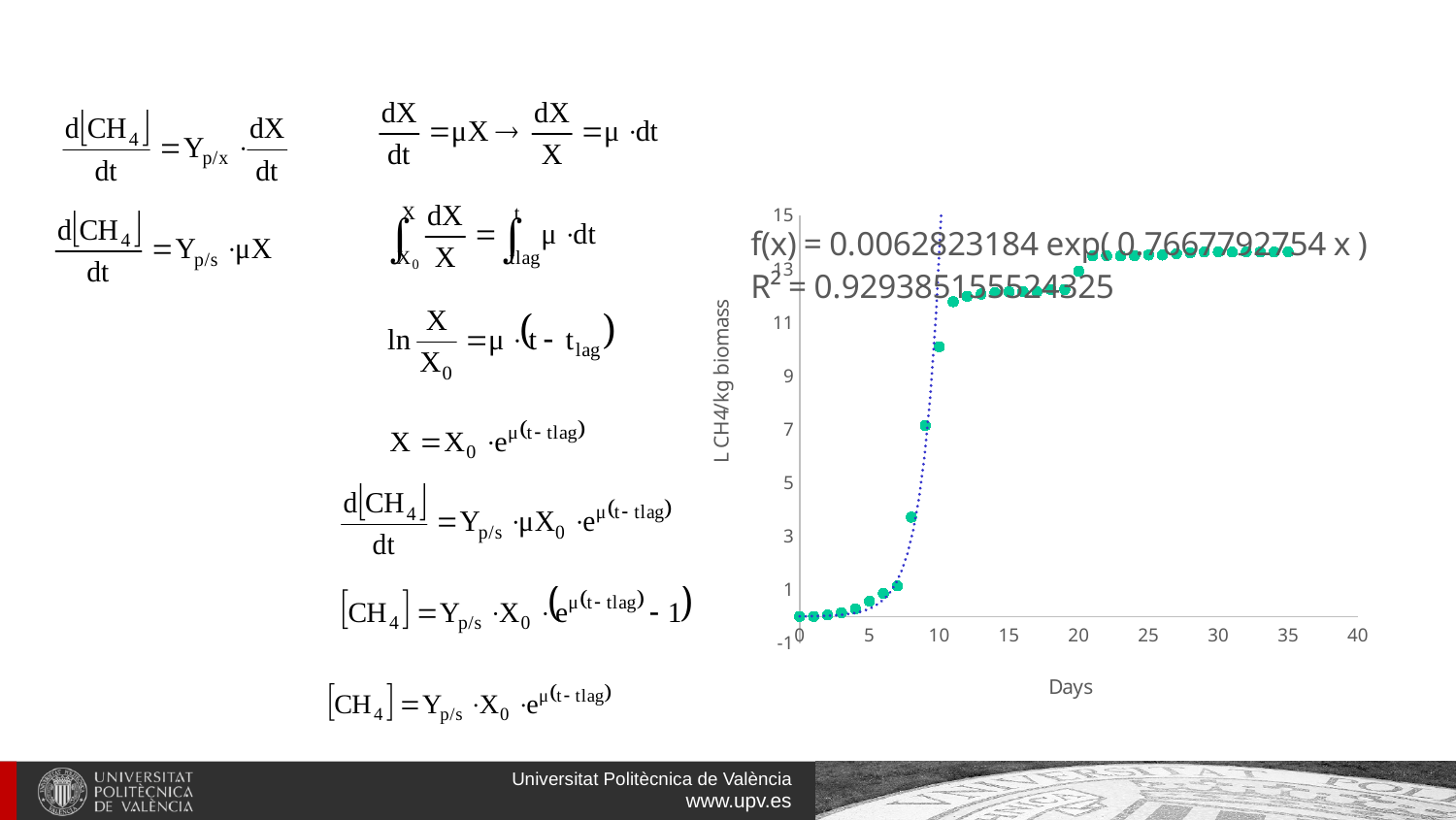
What is the highest tick value shown on the y axis of the chart? 15 Is the value at day 2 greater or less than 1? less Do the plotted values rise or fall as the number of days increases? rise Is the value at day 30 greater or less than 11? greater Is the value at day 8 greater or less than 3? greater What is the title of the y axis of the chart? L CH4/kg biomass What kind of chart is shown on the slide? scatter chart What is the highest tick value shown on the x axis of the chart? 40 What is the title of the x axis of the chart? Days